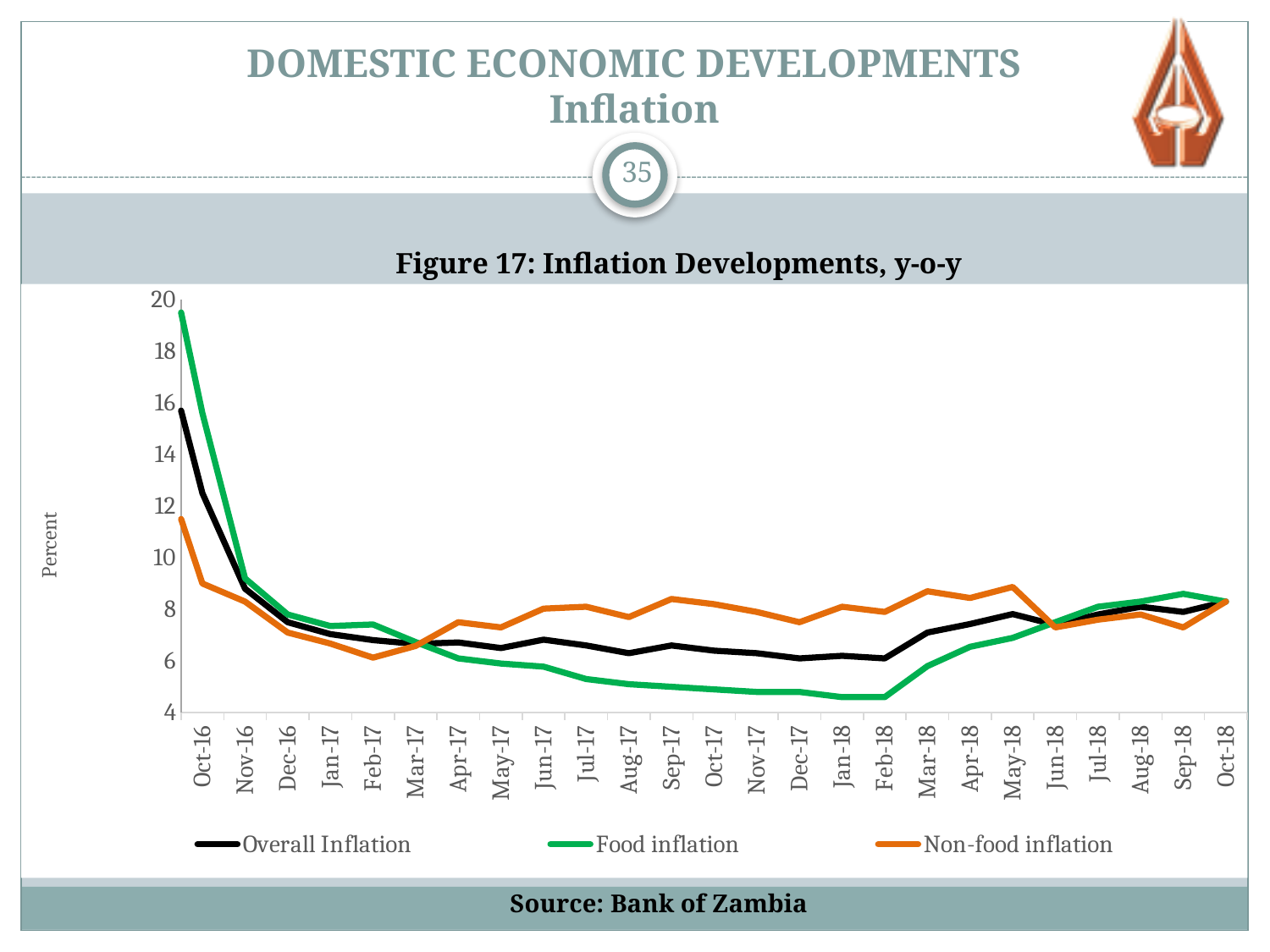
What kind of chart is Figure 17: Inflation Developments, y-o-y? line chart Which series has the lowest value in Feb-18? Food inflation Does Food inflation rise or fall from Oct-16 to Feb-18? fall What label is shown on the y axis of the chart? Percent Which series has the highest value in Oct-16? Food inflation How many series does the legend of the chart list? 3 Is the value for Food inflation in Feb-18 greater or less than 6? less Is the value for Overall Inflation in Oct-16 greater or less than 14? greater Is the value for Non-food inflation in May-18 greater or less than 8? greater In Feb-18, which is larger: Non-food inflation or Food inflation? Non-food inflation How many months are shown along the x axis of the chart? 25